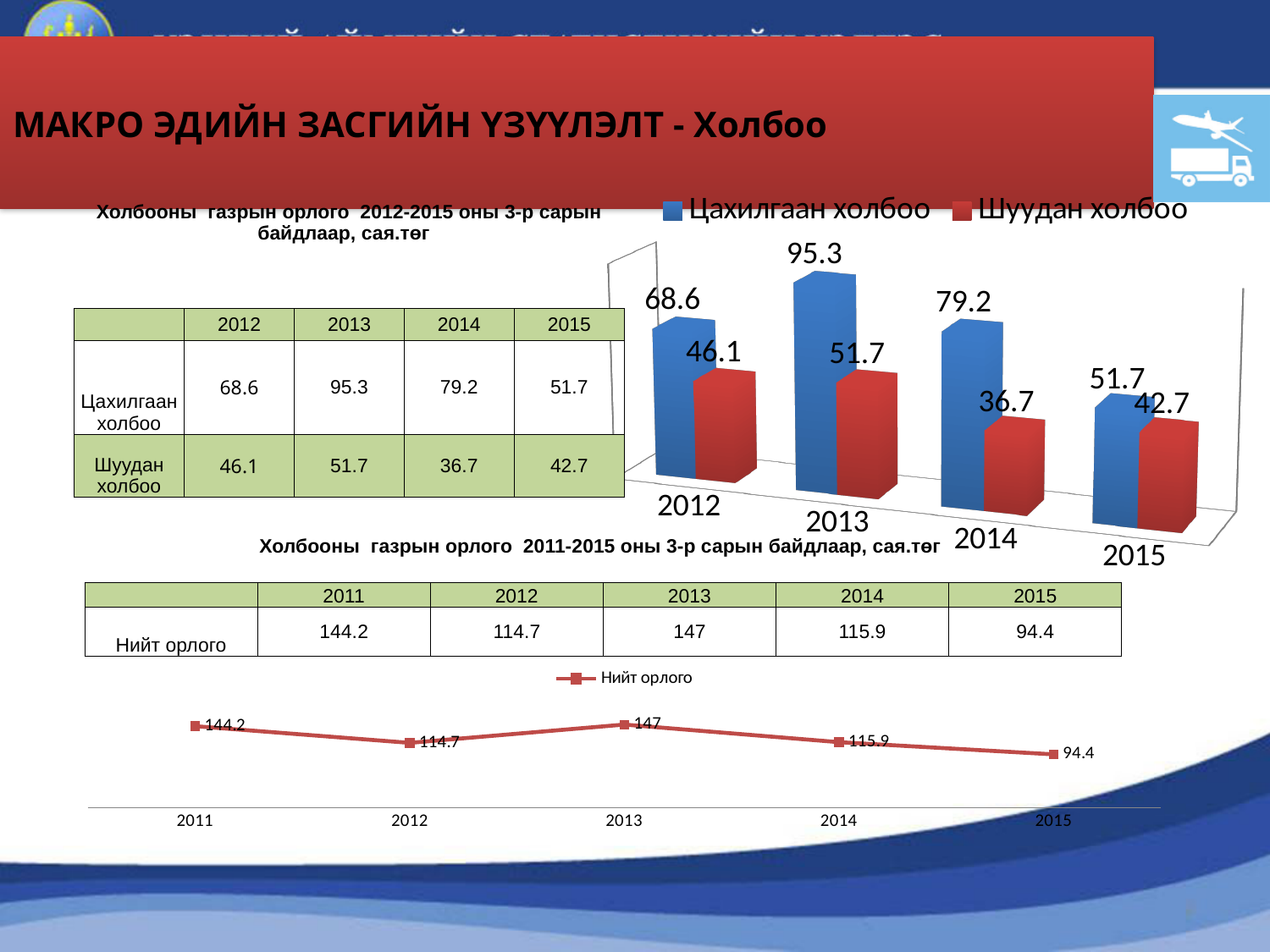
In the line chart at the bottom, which year has the lowest value of Нийт орлого? 2015 In the bar chart at the top right, which year has the highest value for Цахилгаан холбоо? 2013 In the bar chart at the top right, what is the difference between Цахилгаан холбоо and Шуудан холбоо in 2012? 22.5 How many years are plotted in the line chart at the bottom? 5 What kind of chart is the chart at the top right of the slide? bar chart In the line chart at the bottom, what is the value of Нийт орлого in 2013? 147 In the bar chart at the top right, which is larger in 2015: Цахилгаан холбоо or Шуудан холбоо? Цахилгаан холбоо How many series does the legend of the bar chart at the top right list? 2 In the bar chart at the top right, what is the value for Шуудан холбоо in 2014? 36.7 In the line chart at the bottom, what is the difference between Нийт орлого in 2011 and 2015? 49.8 In the bar chart at the top right, what is the value for Цахилгаан холбоо in 2013? 95.3 In the bar chart at the top right, which year has the lowest value for Шуудан холбоо? 2014